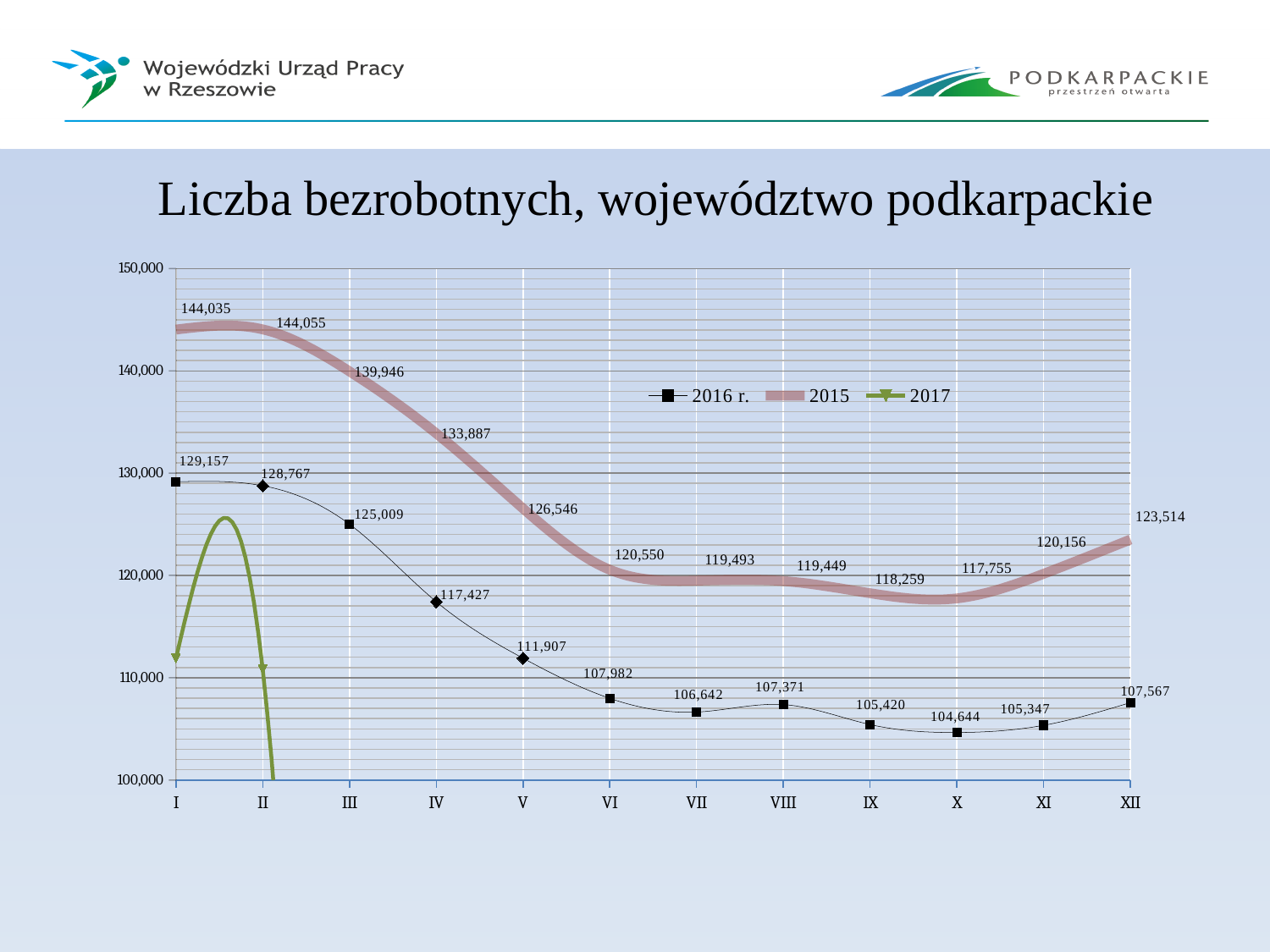
How many series does the legend list? 3 What is the difference between the 2015 and 2016 r. values in month I? 14,878 What is the value for 2016 r. in month X? 104,644 How many months are shown on the x axis? 12 In which month is the 2016 r. series lowest? X What is the value for 2015 in month XII? 123,514 Is the value for 2016 r. in month VI greater or less than 110,000? less What is the value for 2015 in month I? 144,035 What kind of chart is shown on the slide? line chart What is the title of the chart? Liczba bezrobotnych, województwo podkarpackie Which is larger in month XII, the 2015 value or the 2016 r. value? 2015 Does the 2015 series rise or fall from month I to month X? fall